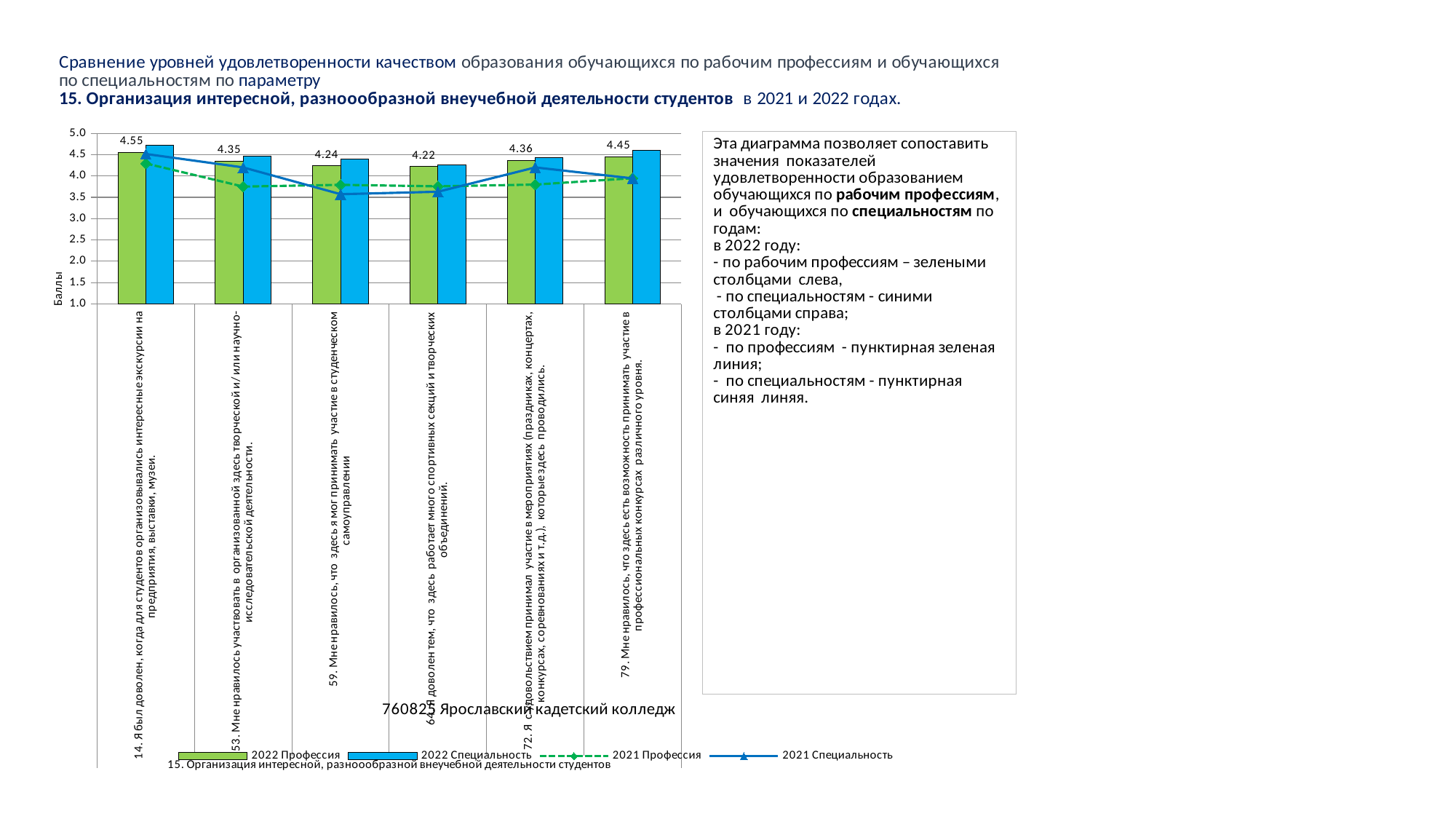
Which is larger for 2022 Профессия: category 14 or category 79? Category 14 (4.55) Which category has the highest 2022 Профессия value? 14. Я был доволен, когда для студентов организовывались интересные экскурсии на предприятия, выставки, музеи (4.55) What is the difference between the highest and lowest 2022 Профессия values (4.55 and 4.22)? 0.33 Is the 2021 Специальность value for category 59 greater or less than 4.0? less How many categories (survey statements) are shown on the x axis? 6 How many series does the legend list? 4 What is the 2022 Профессия value for category 14 (Я был доволен, когда для студентов организовывались интересные экскурсии на предприятия, выставки, музеи)? 4.55 Is the 2022 Специальность value for category 14 greater or less than 4.5? greater Which category has the lowest 2022 Профессия value? 64. Я доволен тем, что здесь работает много спортивных секций и творческих объединений (4.22) What is the title of the vertical axis? Баллы What is the 2022 Профессия value for category 79 (Мне нравилось, что здесь есть возможность принимать участие в профессиональных конкурсах различного уровня)? 4.45 What is the 2022 Профессия value for category 64 (Я доволен тем, что здесь работает много спортивных секций и творческих объединений)? 4.22